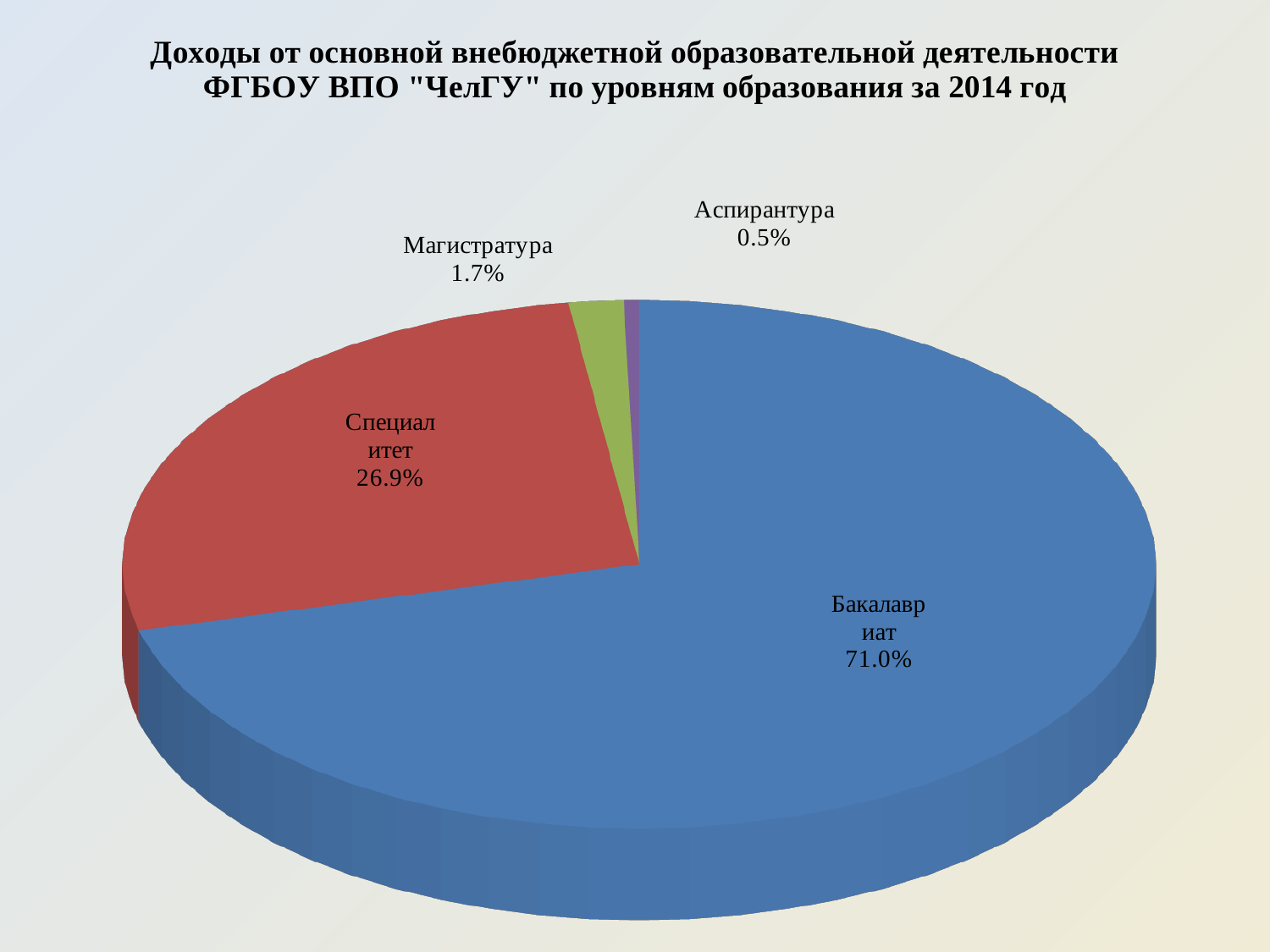
What is the value shown for Аспирантура? 0.5% What kind of chart is shown on the slide? Pie chart What is the difference in percentage points between Магистратура and Аспирантура? 1.2 Which category has the smallest slice of the pie? Аспирантура Which category has the largest slice of the pie? Бакалавриат Which is larger, the share for Специалитет or the share for Магистратура? Специалитет What colour is the slice for Специалитет? Red What share of the pie does Бакалавриат account for? 71.0% What is the difference in percentage points between Бакалавриат and Специалитет? 44.1 How many categories are shown in the pie chart? 4 What is the value shown for Магистратура? 1.7% What is the value shown for Специалитет? 26.9%